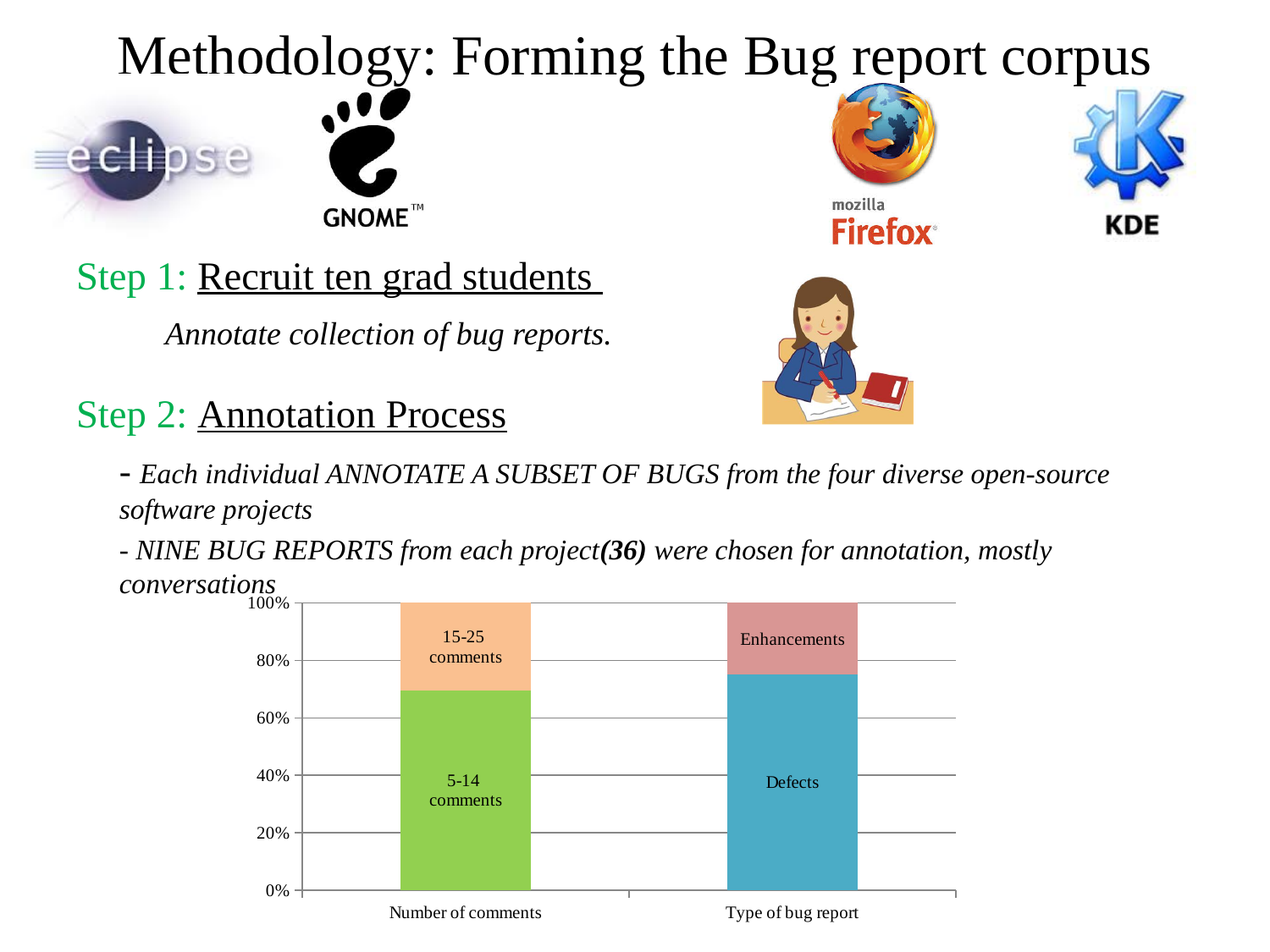
In the 'Number of comments' bar, which segment is larger: '5-14 comments' or '15-25 comments'? 5-14 comments Is the share of 'Defects' in the 'Type of bug report' bar greater or less than 60%? greater Is the share of 'Enhancements' in the 'Type of bug report' bar greater or less than 40%? less What is the highest value shown on the y axis of the chart? 100% In the 'Type of bug report' bar, which segment is larger: 'Defects' or 'Enhancements'? Defects What kind of chart is shown on the slide? stacked bar chart What is the total height of the 'Type of bug report' stacked bar? 100% Is the share of '5-14 comments' in the 'Number of comments' bar greater or less than 60%? greater What are the two categories on the x axis of the chart? Number of comments; Type of bug report How many bars (categories) are shown on the x axis of the chart? 2 Which two segments make up the 'Number of comments' bar? 5-14 comments; 15-25 comments